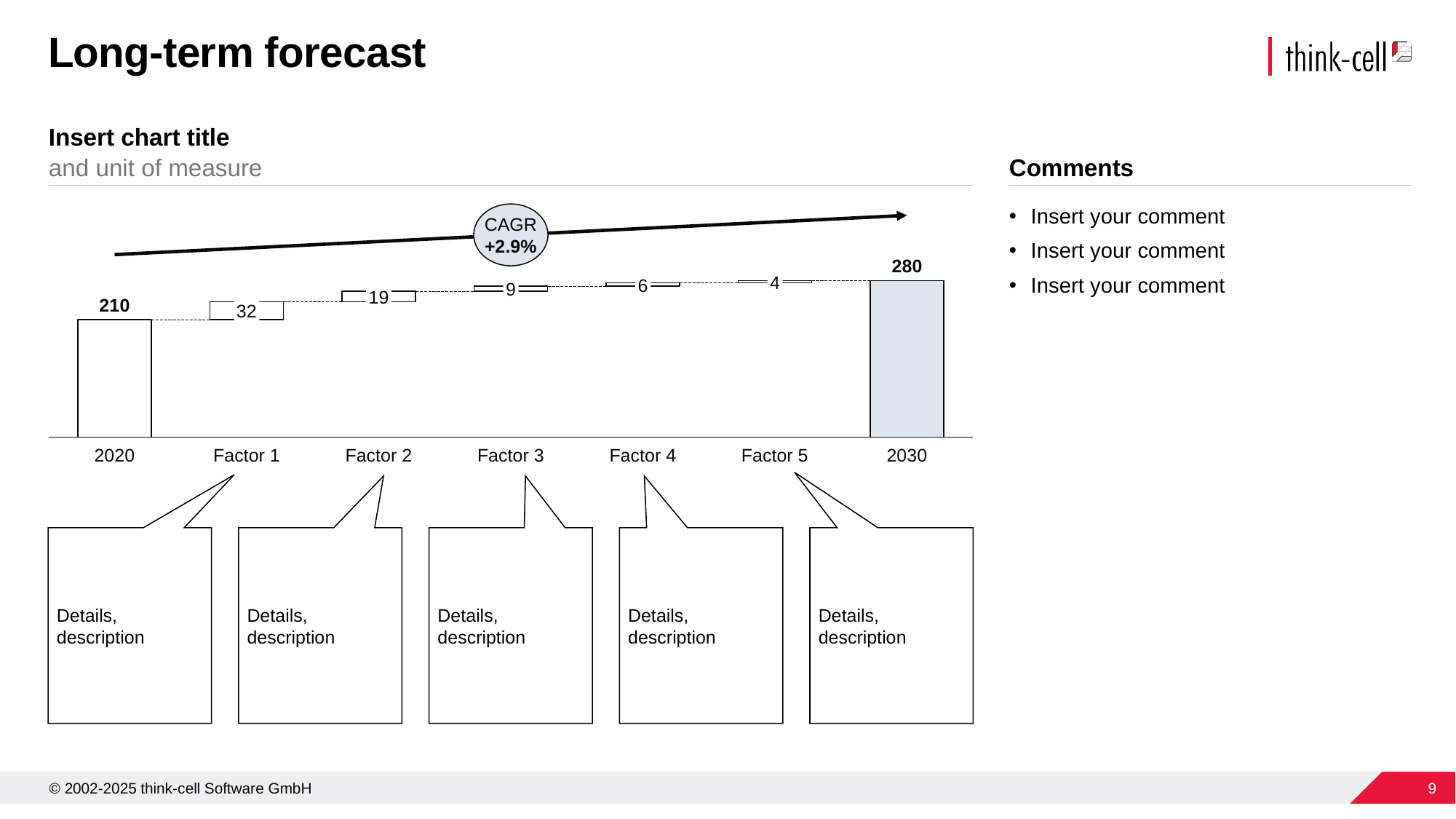
What is the value shown for 2030? 280 Which step is larger, Factor 2 or Factor 4? Factor 2 What is the value of the Factor 1 step? 32 What is the value of the Factor 3 step? 9 What is the value shown for 2020? 210 What CAGR is shown on the chart? +2.9% Do the values rise or fall from 2020 to 2030? rise What is the value of the Factor 5 step? 4 Which factor contributes the smallest increase? Factor 5 What is the difference between the 2030 value and the 2020 value? 70 Which factor contributes the largest increase? Factor 1 How many factor steps are shown between 2020 and 2030? 5